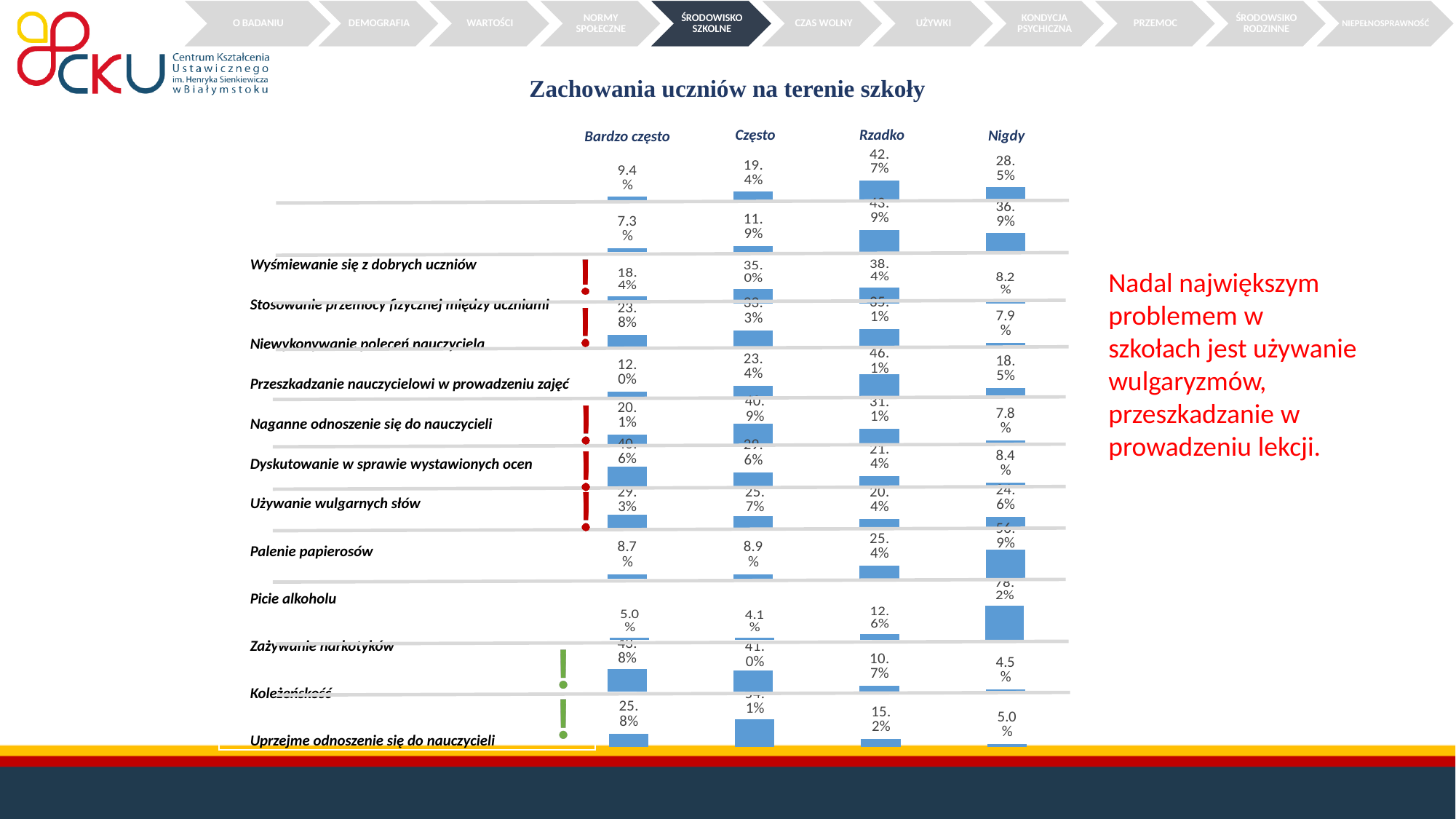
For 'Zażywanie narkotyków', which is larger: the 'Bardzo często' value or the 'Często' value? Bardzo często What is the title of the chart? Zachowania uczniów na terenie szkoły For 'Przeszkadzanie nauczycielowi w prowadzeniu zajęć', which response category has the highest value? Rzadko How many student behaviours are listed in the chart? 12 How many response categories (columns) does the chart show? 4 What kind of chart is shown on the slide? bar chart What is the 'Często' value for 'Niewykonywanie poleceń nauczyciela'? 35.0% What is the 'Bardzo często' value for 'Zażywanie narkotyków'? 5.0% What is the 'Nigdy' value for 'Koleżeńskość'? 4.5% What is the 'Rzadko' value for 'Wyśmiewanie się z dobrych uczniów'? 42.7% What is the 'Rzadko' value for 'Przeszkadzanie nauczycielowi w prowadzeniu zajęć'? 35.1% For 'Wyśmiewanie się z dobrych uczniów', what is the difference between the 'Rzadko' value and the 'Nigdy' value? 14.2 percentage points